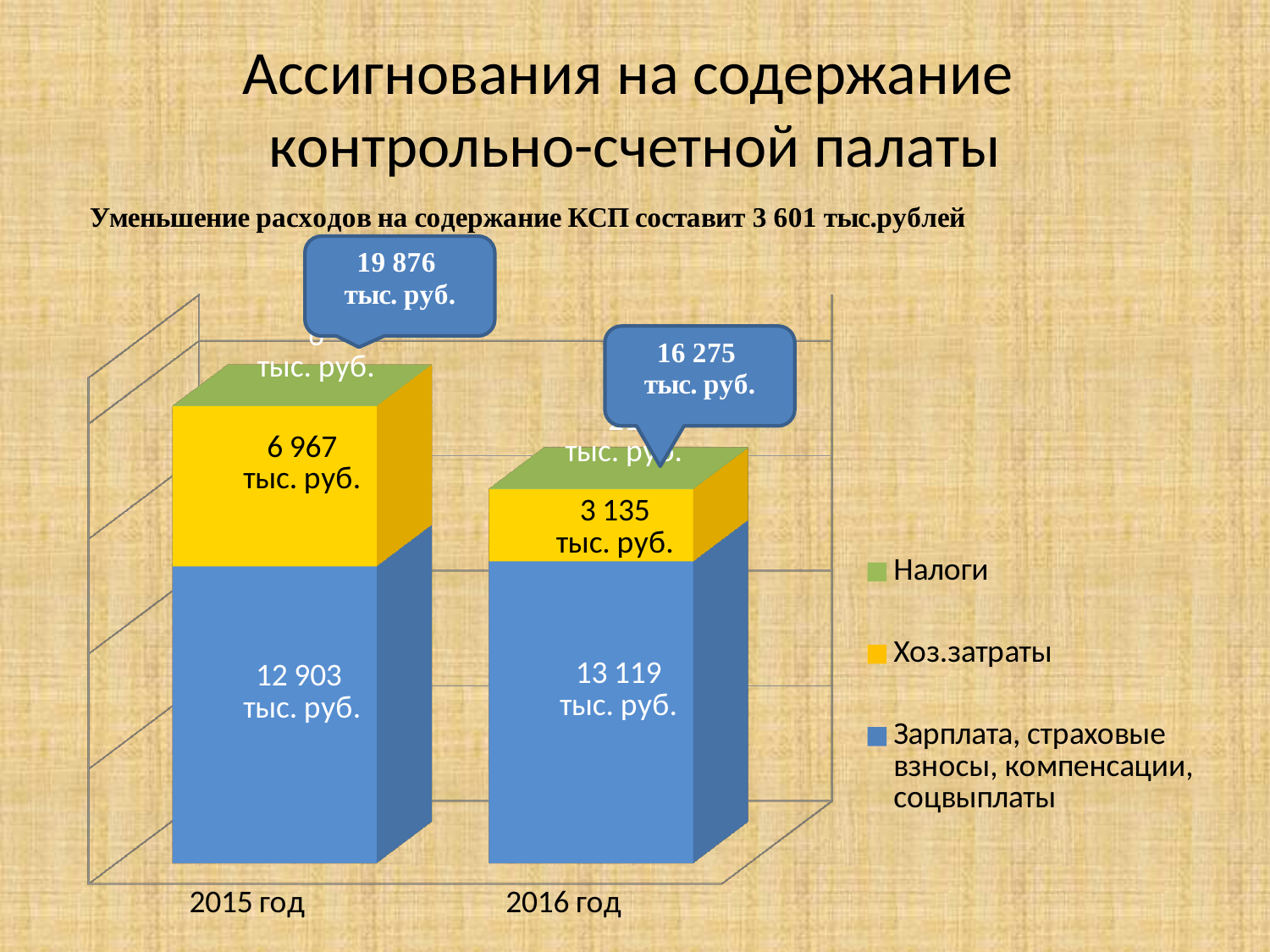
Does the total of the stacked bars rise or fall from 2015 год to 2016 год? Fall What is the value for Зарплата, страховые взносы, компенсации, соцвыплаты in 2015 год? 12 903 тыс. руб. What is the total of the stacked bar for 2015 год? 19 876 тыс. руб. What is the difference between Хоз.затраты in 2015 год and in 2016 год? 3 832 тыс. руб. Which year has the larger value for Зарплата, страховые взносы, компенсации, соцвыплаты: 2015 год or 2016 год? 2016 год By how much does the total for 2016 год differ from the total for 2015 год? 3 601 тыс. руб. What is the value for Зарплата, страховые взносы, компенсации, соцвыплаты in 2016 год? 13 119 тыс. руб. What is the value for Хоз.затраты in 2015 год? 6 967 тыс. руб. What is the total of the stacked bar for 2016 год? 16 275 тыс. руб. What kind of chart is shown on the slide? Stacked bar chart How many series does the legend list? 3 What is the value for Хоз.затраты in 2016 год? 3 135 тыс. руб.